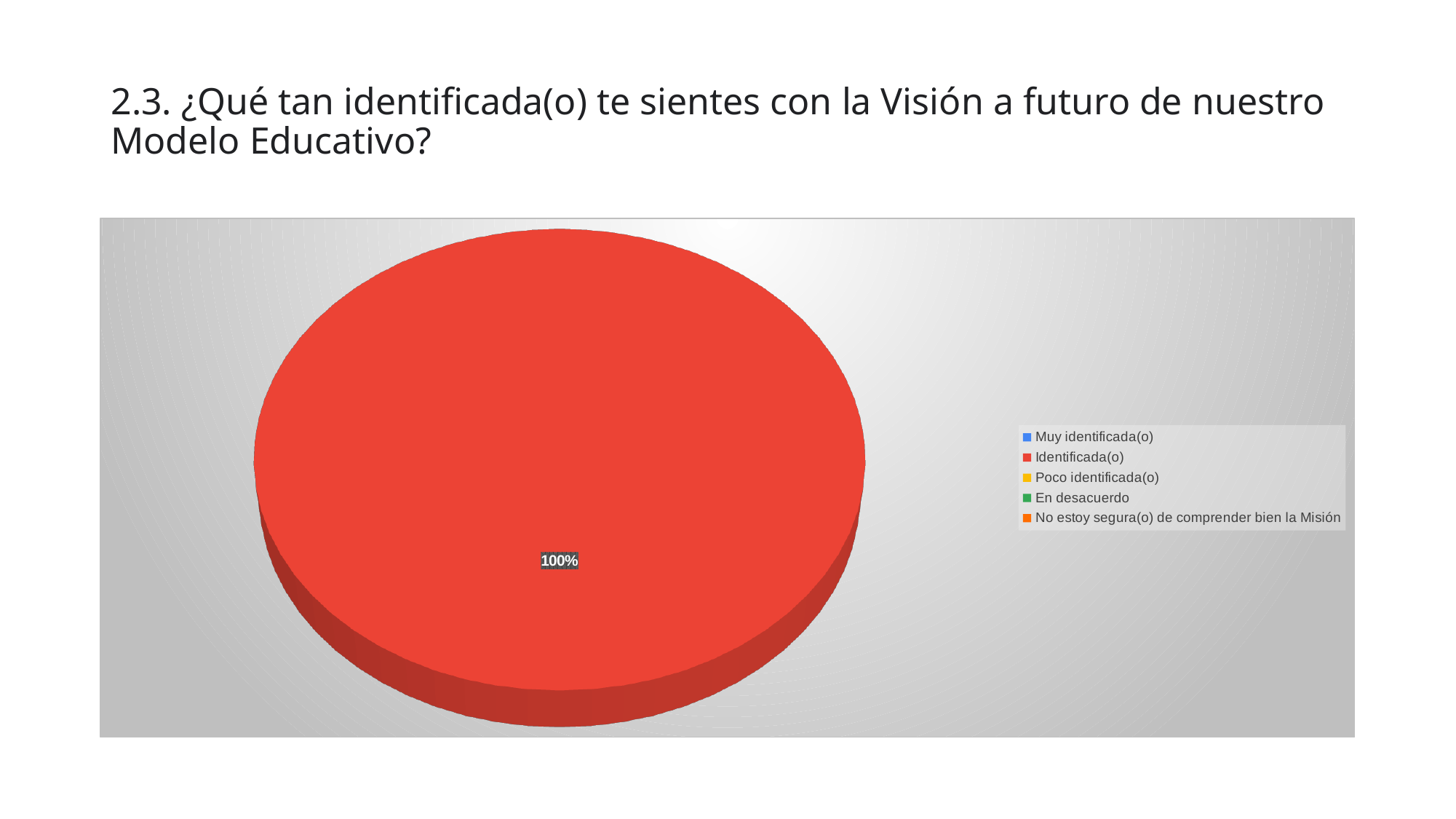
How many categories does the legend list? 5 What colour is the Identificada(o) slice? red What kind of chart is shown on the slide? pie chart Which legend entry is listed last? No estoy segura(o) de comprender bien la Misión Is the share for Identificada(o) greater or less than 50%? greater What is the only percentage label printed on the pie? 100% Which is larger, the share for Identificada(o) or the share for Muy identificada(o)? Identificada(o) What share of the pie does the Identificada(o) slice represent? 100% Which category has the largest share of the pie? Identificada(o)